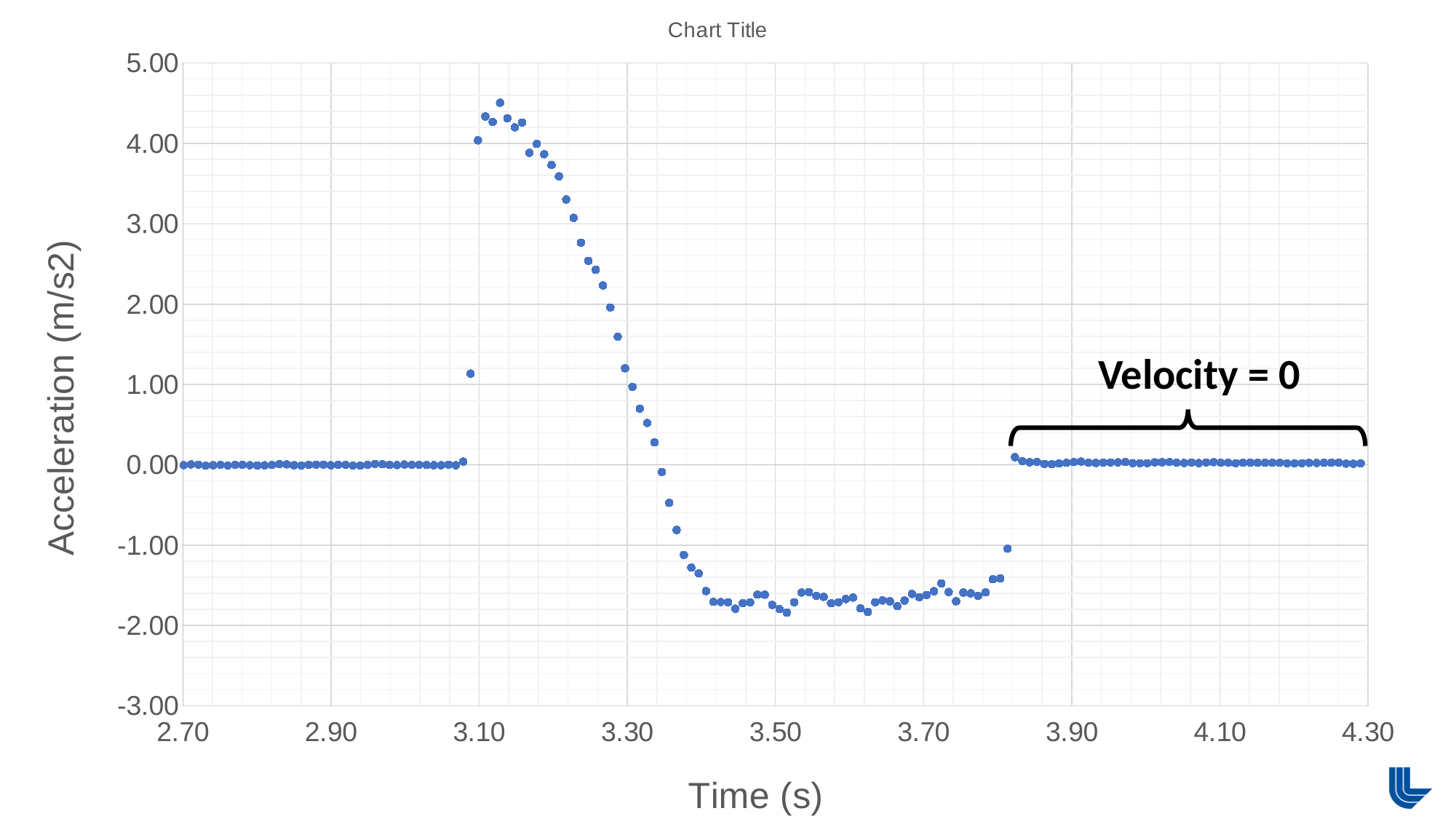
What text does the annotation above the bracket on the right side of the chart read? Velocity = 0 Which is larger, the acceleration at time 2.90 s or the acceleration at time 3.60 s? 2.90 s Is the acceleration at time 2.90 s greater or less than 1.00? less What kind of chart is shown on the slide? scatter chart Is the acceleration at time 3.20 s greater or less than 3.00? greater Is the acceleration at time 4.10 s greater or less than 1.00? less Which is larger, the acceleration at time 3.20 s or the acceleration at time 3.50 s? 3.20 s What is the title of the vertical axis? Acceleration (m/s2) Between time 3.10 s and 3.40 s, do the plotted acceleration values rise or fall? fall